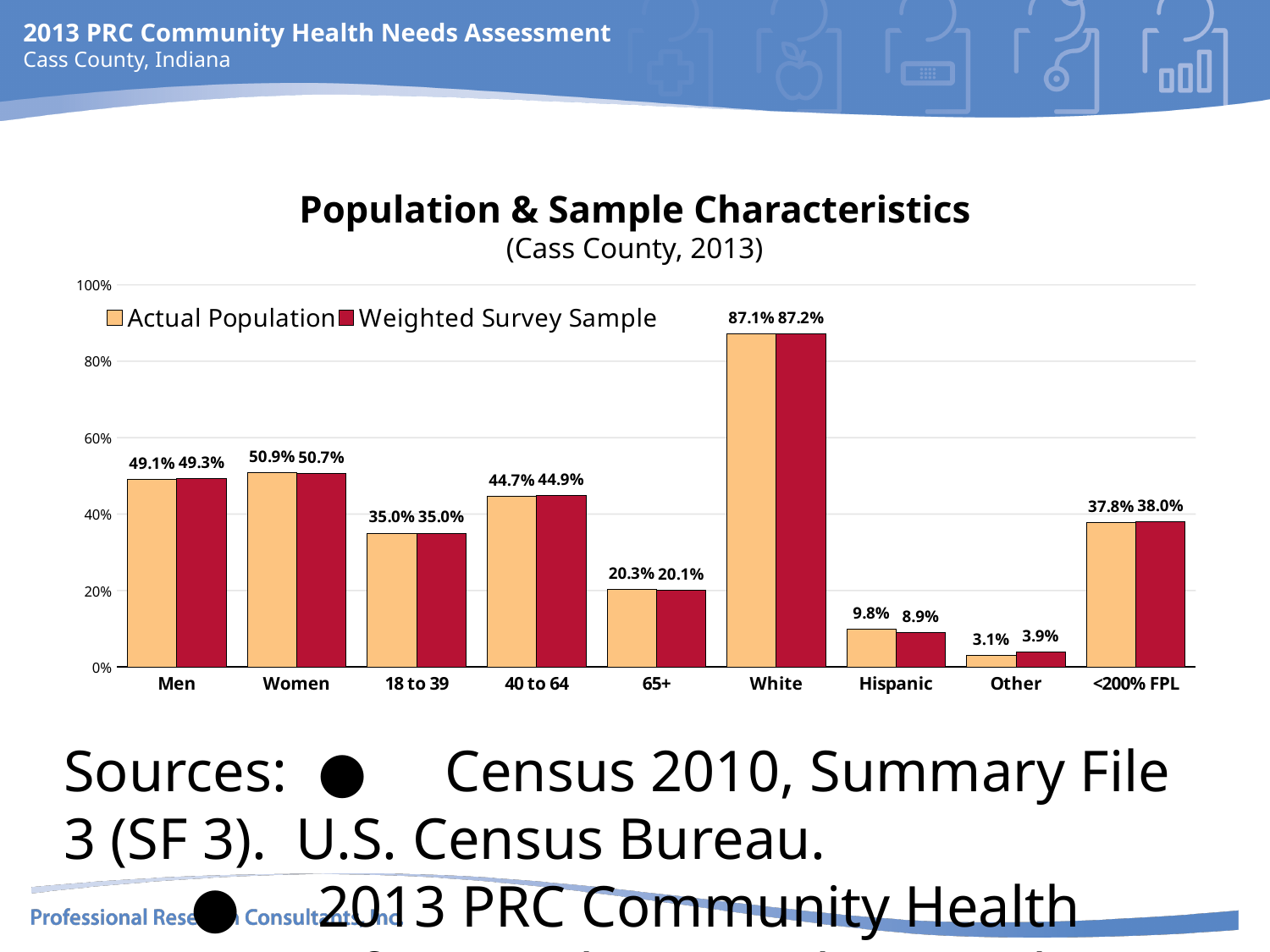
How many series does the legend list? 2 How many categories are shown on the x axis? 9 What is the title of the chart? Population & Sample Characteristics What is the Actual Population value for <200% FPL? 37.8% What kind of chart is shown on the slide? Bar chart What is the Actual Population value for Men? 49.1% Is the Actual Population value for 40 to 64 greater or less than 40%? greater Which category has the highest Weighted Survey Sample value? White Which is larger for Other: the Actual Population value or the Weighted Survey Sample value? Weighted Survey Sample What is the Weighted Survey Sample value for Hispanic? 8.9% What is the difference between the Actual Population and Weighted Survey Sample values for Hispanic? 0.9% Which category has the lowest Actual Population value? Other